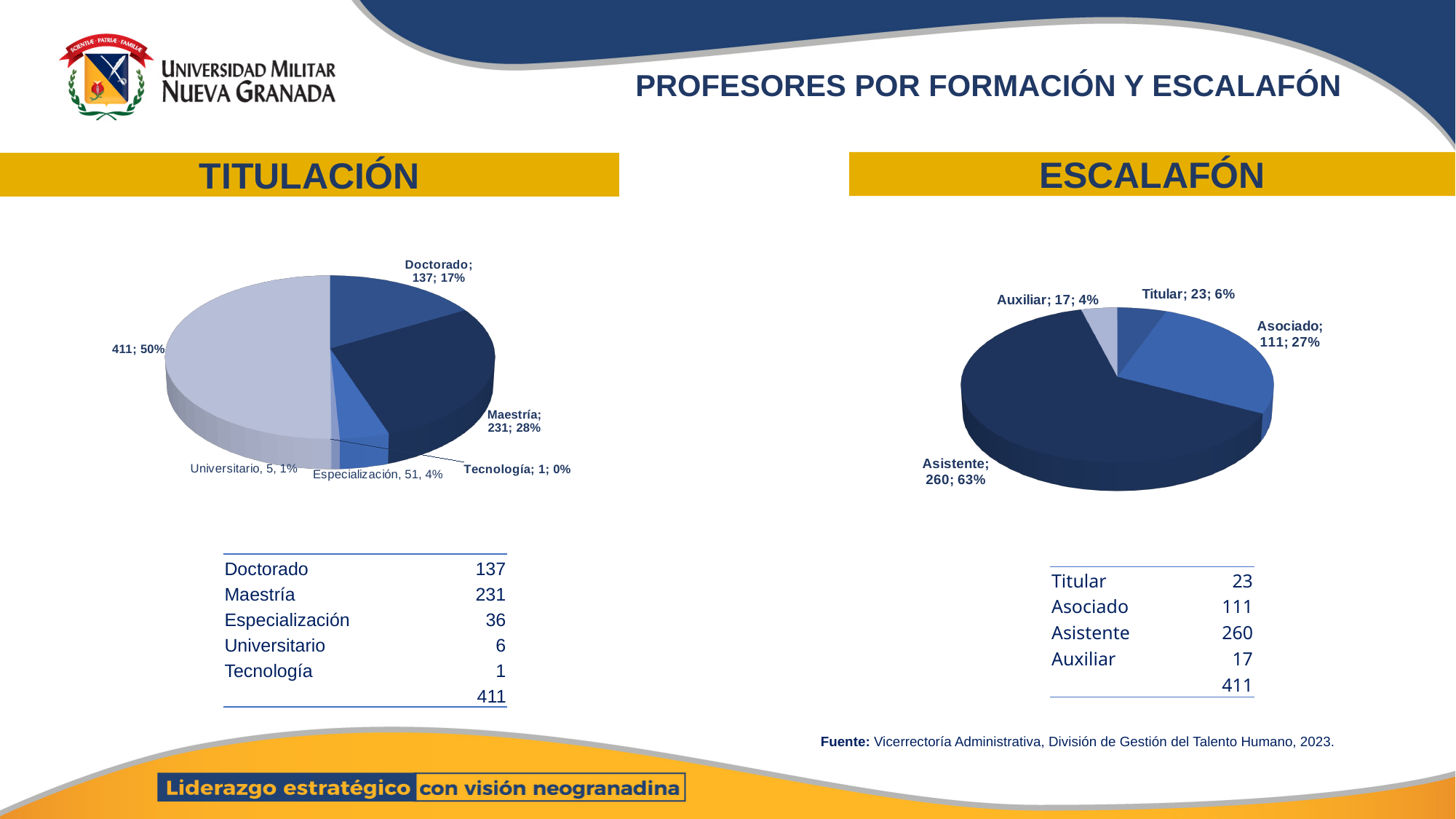
In the ESCALAFÓN pie chart, what value is shown for Asistente? 260 In the TITULACIÓN pie chart, what percentage share does Doctorado have? 17% What type of chart is used on the ESCALAFÓN side of the slide? Pie chart In the TITULACIÓN pie chart, what value is shown for Maestría? 231 In the TITULACIÓN pie chart, what is the difference between the values for Maestría and Doctorado? 94 In the ESCALAFÓN pie chart, what percentage share does Asociado have? 27% In the TITULACIÓN pie chart, which is larger, the Doctorado slice or the Maestría slice? Maestría In the ESCALAFÓN pie chart, what is the difference between the values for Asociado and Titular? 88 In the ESCALAFÓN pie chart, which category has the smallest slice? Auxiliar In the ESCALAFÓN pie chart, which category has the largest slice? Asistente In the ESCALAFÓN pie chart, how many categories are shown? 4 In the TITULACIÓN pie chart, what value is shown for Tecnología? 1